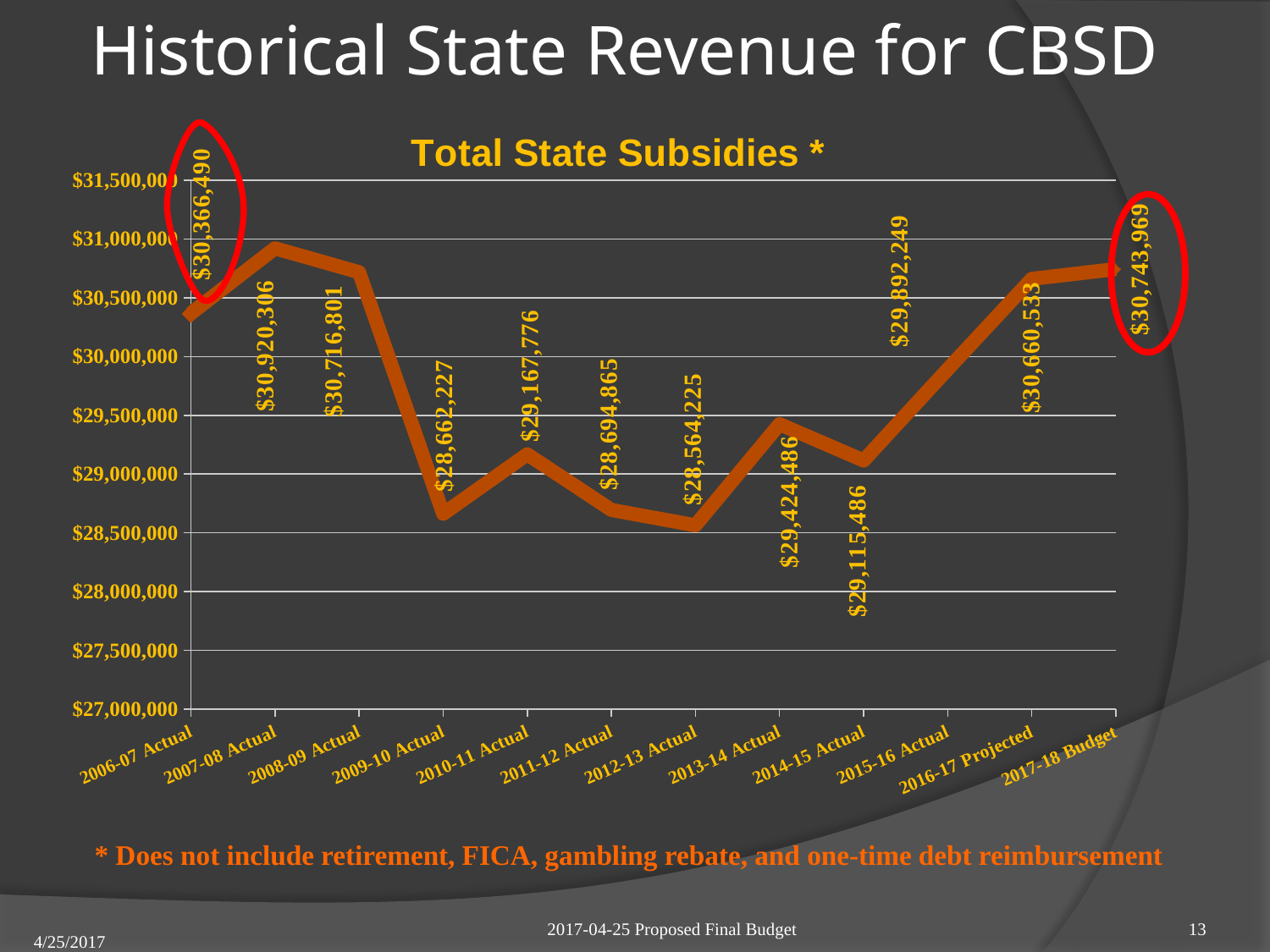
What is the difference between the 2013-14 Actual value and the 2012-13 Actual value? $860,261 How many years are plotted on the chart? 12 Which year has the lowest total state subsidies? 2012-13 Actual Which year has the highest total state subsidies? 2007-08 Actual What is the value for 2016-17 Projected? $30,660,533 What is the difference between the 2017-18 Budget value and the 2016-17 Projected value? $83,436 What kind of chart is shown on the slide? line chart What is the value for 2012-13 Actual? $28,564,225 What is the value for 2017-18 Budget? $30,743,969 Is the value for 2009-10 Actual greater or less than $29,000,000? less What is the value for 2007-08 Actual? $30,920,306 Which is larger, the value for 2010-11 Actual or the value for 2011-12 Actual? 2010-11 Actual